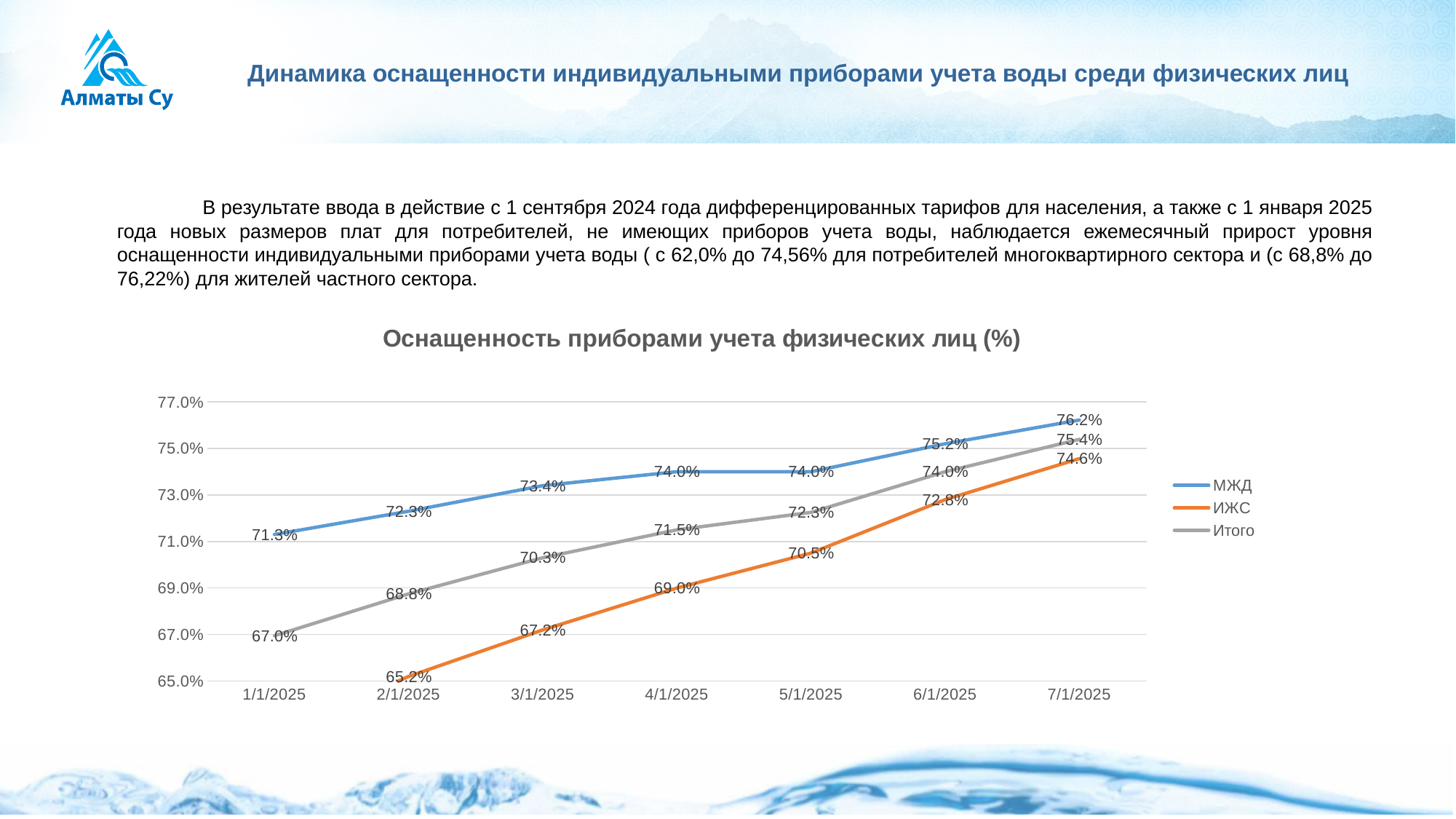
On which date does the МЖД series reach its highest value? 7/1/2025 What is the difference between the ИЖС values on 7/1/2025 and 2/1/2025? 9.4% What is the title of the chart? Оснащенность приборами учета физических лиц (%) How many series does the legend list? 3 What is the value for МЖД on 1/1/2025? 71.3% What type of chart is shown on the slide? line chart Which is larger on 6/1/2025: the value for МЖД or the value for ИЖС? МЖД Does the Итого series rise or fall from 1/1/2025 to 7/1/2025? rise What is the value for Итого on 4/1/2025? 71.5% What is the value for МЖД on 7/1/2025? 76.2% On which date is the Итого series at its lowest value? 1/1/2025 What is the value for ИЖС on 5/1/2025? 70.5%